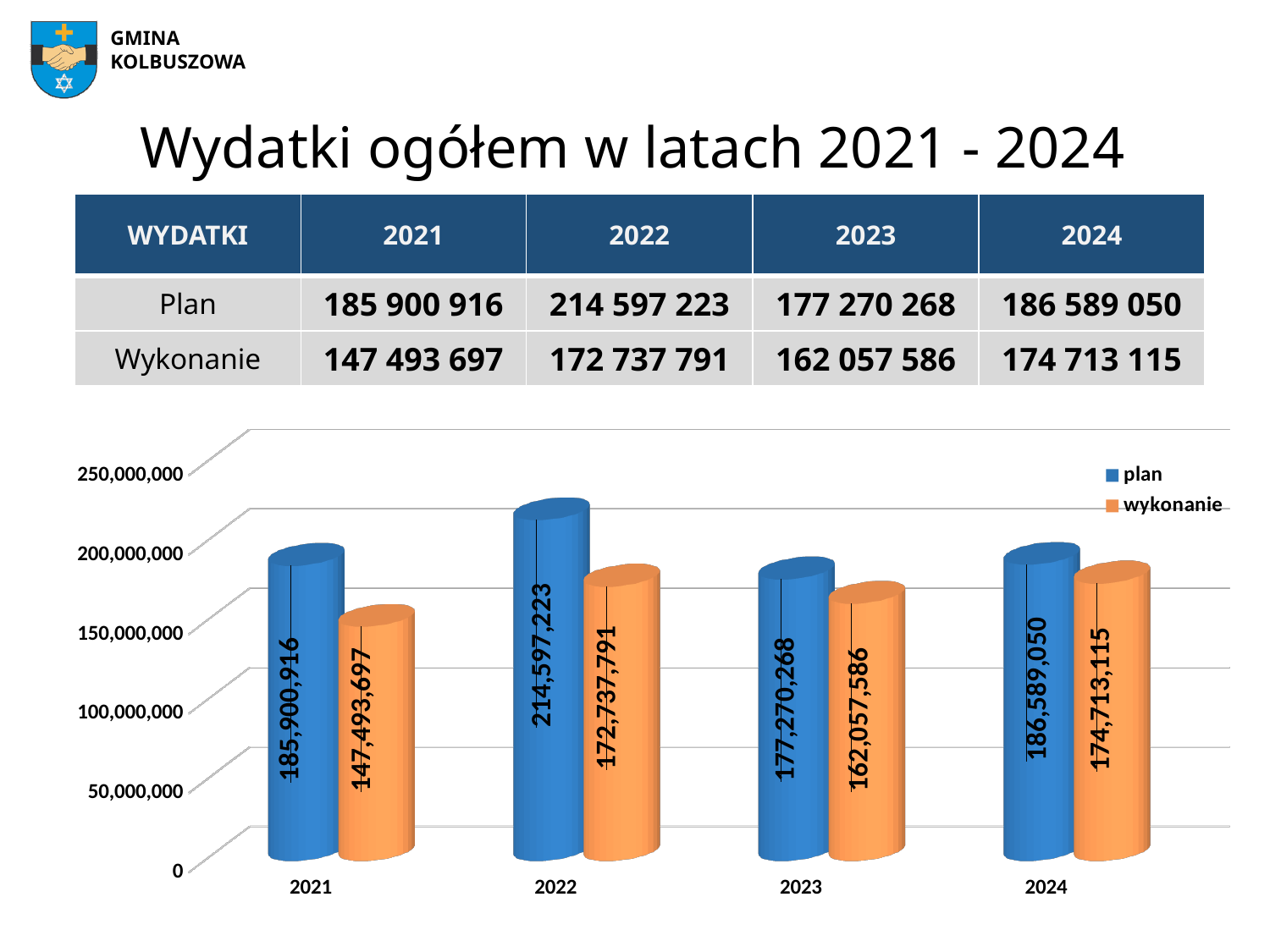
Which is larger in the chart: the plan value for 2021 or the plan value for 2023? plan value for 2021 Which year has the highest plan value in the chart? 2022 How many series does the chart legend list? 2 Which year has the lowest plan value in the chart? 2023 Is the plan value for 2022 greater or less than 200,000,000? greater What is the wykonanie value for 2023 in the chart? 162,057,586 What type of chart is shown on the slide? bar chart What is the difference between plan and wykonanie for 2024 in the chart? 11,875,935 Which year has the lowest wykonanie value in the chart? 2021 What is the difference between plan and wykonanie for 2022 in the chart? 41,859,432 What is the wykonanie value for 2021 in the chart? 147,493,697 What is the plan value for 2022 in the chart? 214,597,223